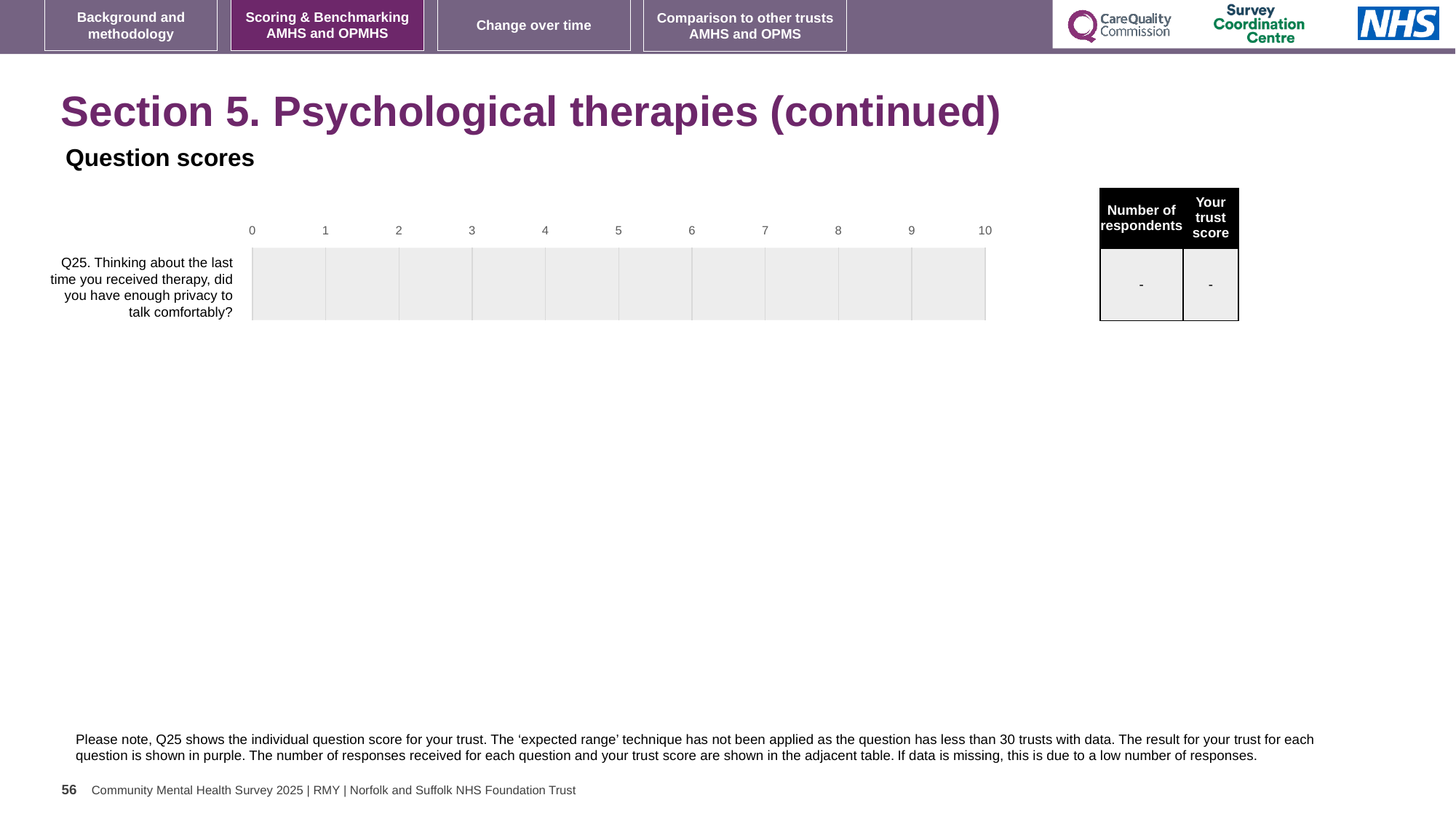
What is the trust score shown for Q25 in the table next to the chart? - What is the lowest value shown on the x axis of the question scores chart? 0 What kind of chart is used to show the question scores on this slide? bar chart How many questions are listed as categories in the question scores chart? 1 What is the number of respondents shown for Q25 in the table next to the chart? - What is the highest value shown on the x axis of the question scores chart? 10